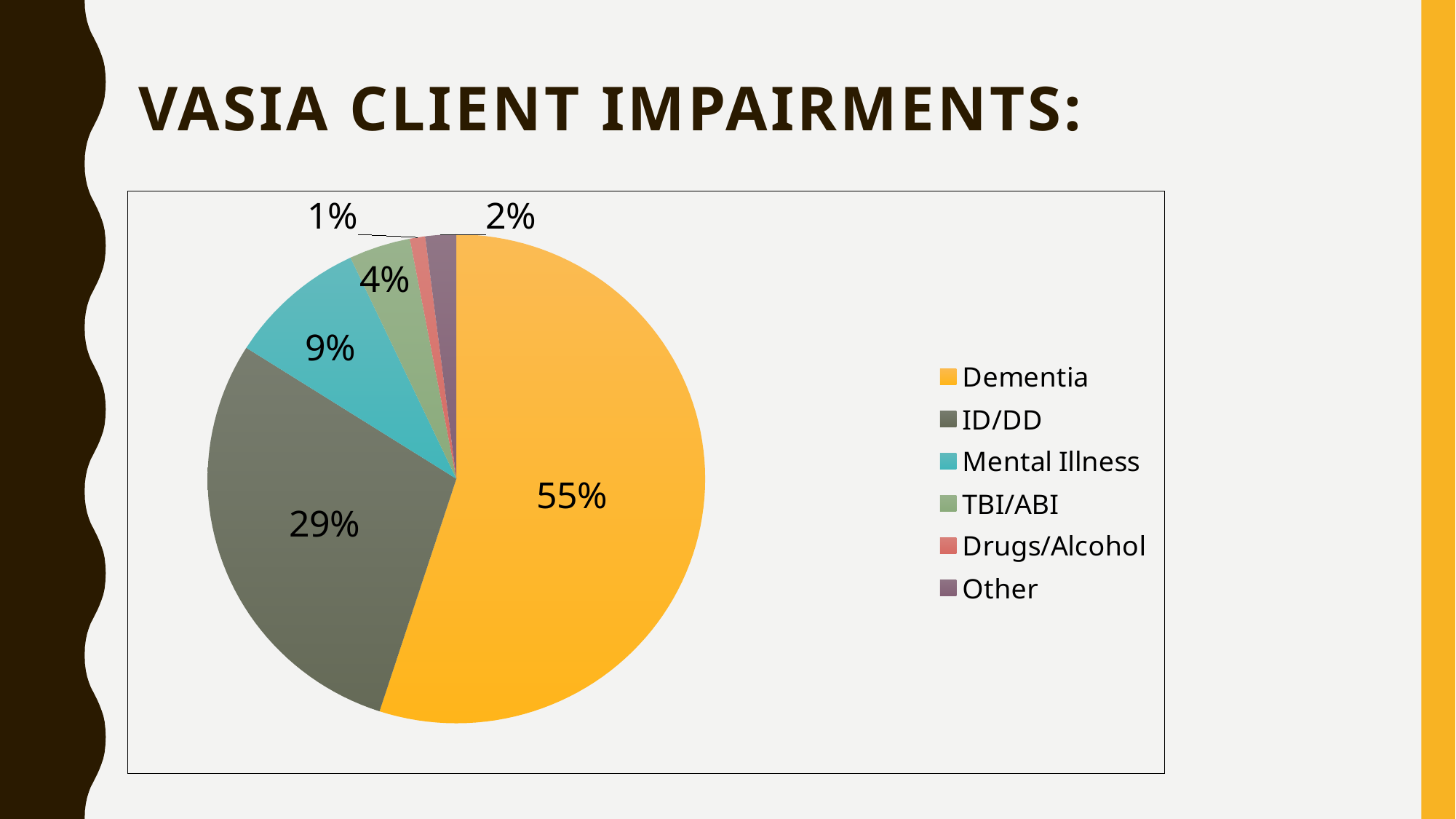
What is the value shown for TBI/ABI? 4% What share of the pie does ID/DD represent? 29% What is the value shown for Drugs/Alcohol? 1% What is the value shown for Other? 2% Which category has the largest share of the pie? Dementia What is the difference in percentage points between Dementia and ID/DD? 26 Which category has the smallest share of the pie? Drugs/Alcohol What share of the pie does Dementia represent? 55% How many categories does the legend list? 6 What kind of chart is shown on the slide? pie chart Which is larger, the share for Mental Illness or the share for TBI/ABI? Mental Illness What is the value shown for Mental Illness? 9%